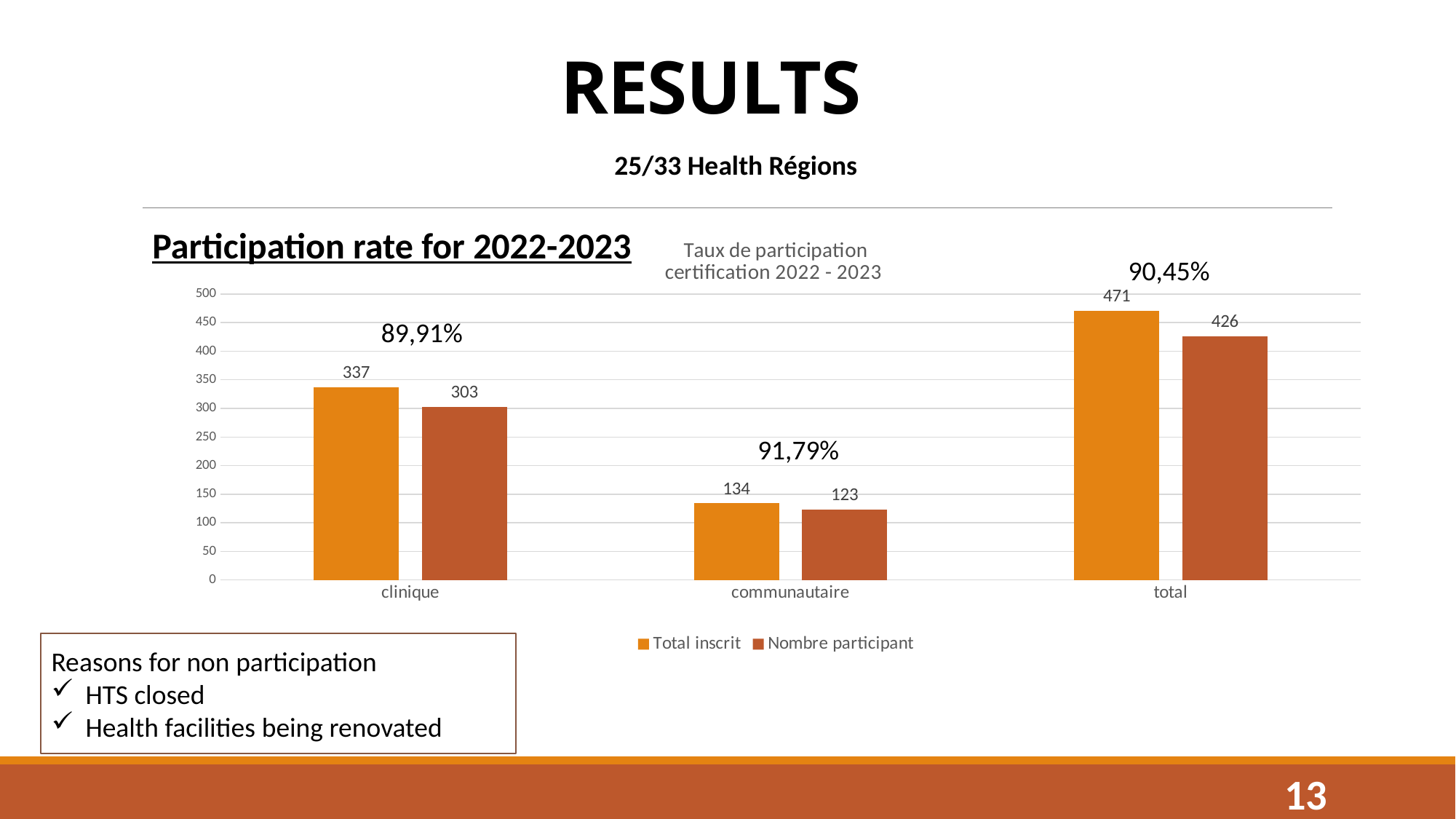
What participation rate is shown above the communautaire bars? 91,79% Which is larger for communautaire: Total inscrit or Nombre participant? Total inscrit Which category has the lowest Total inscrit value? communautaire How many categories are shown on the x axis? 3 How many series does the legend list? 2 What is the value of Nombre participant for communautaire? 123 Which category has the highest Nombre participant value? total What is the value of Total inscrit for clinique? 337 What kind of chart is shown on the slide? bar chart What is the value of Total inscrit for total? 471 Is the Nombre participant value for total greater or less than 400? greater What is the difference between Total inscrit and Nombre participant for clinique? 34